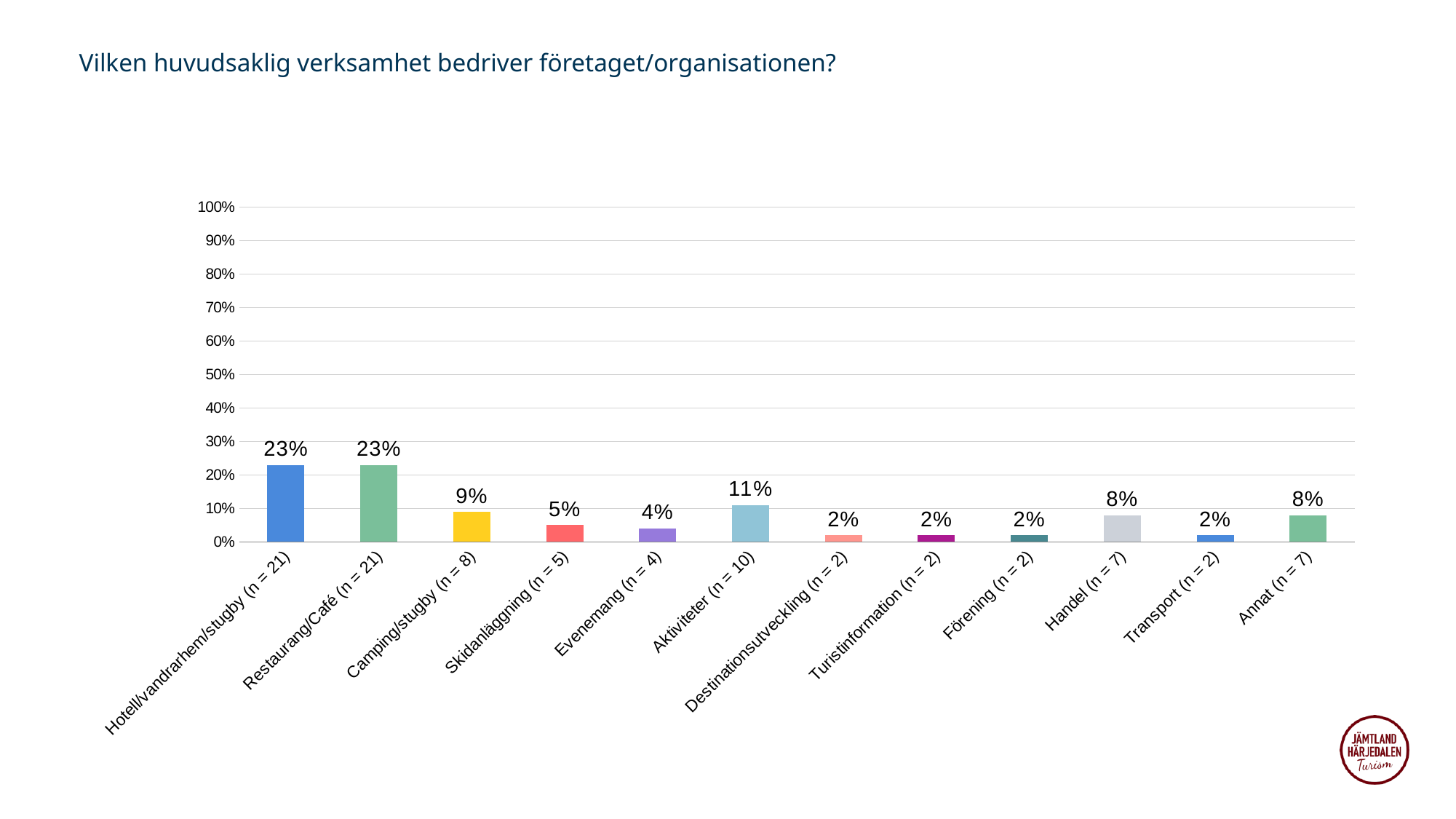
What is the difference between the values for Camping/stugby and Evenemang? 5% How many categories are shown on the x axis? 12 What is the value for Aktiviteter (n = 10)? 11% What is the difference between the values for Hotell/vandrarhem/stugby and Aktiviteter? 12% What is the title of the slide? Vilken huvudsaklig verksamhet bedriver företaget/organisationen? Which is larger, the value for Annat or the value for Skidanläggning? Annat What is the value for Restaurang/Café (n = 21)? 23% What kind of chart is shown on the slide? Bar chart Is the value for Hotell/vandrarhem/stugby greater or less than 20%? greater What is the value for Camping/stugby (n = 8)? 9% What is the value for Handel (n = 7)? 8% What is the value for Skidanläggning (n = 5)? 5%